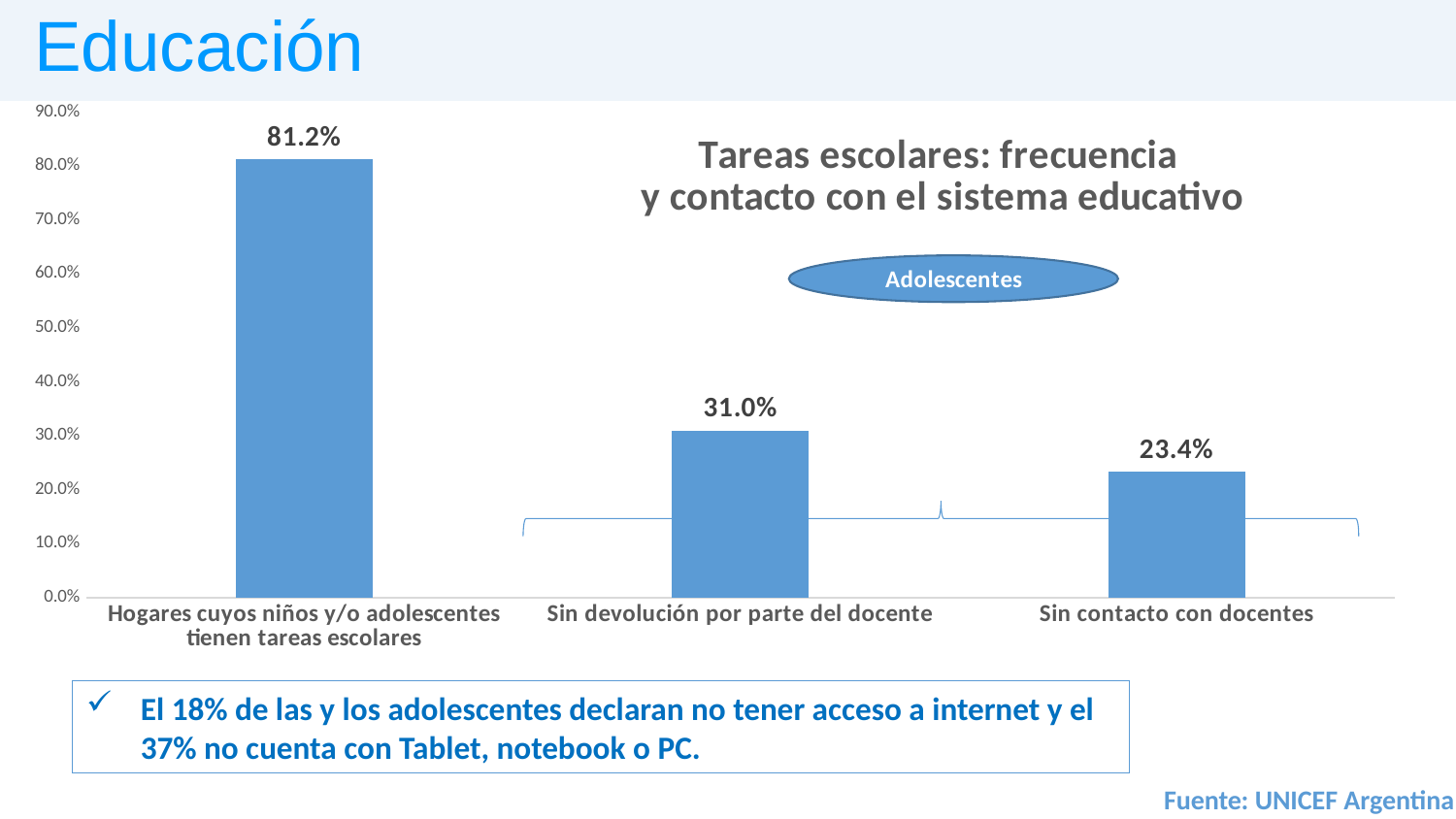
What kind of chart is shown on the slide? Bar chart Which category has the lowest value? Sin contacto con docentes Which is larger: the value for 'Sin devolución por parte del docente' or 'Sin contacto con docentes'? Sin devolución por parte del docente Is the value for 'Sin contacto con docentes' greater or less than 30.0%? less What is the value for 'Sin contacto con docentes'? 23.4% What is the difference between the values for 'Sin devolución por parte del docente' and 'Sin contacto con docentes'? 7.6% What is the title of the chart? Tareas escolares: frecuencia y contacto con el sistema educativo What is the value for 'Sin devolución por parte del docente'? 31.0% How many categories are shown in the chart? 3 What is the difference between the values for 'Hogares cuyos niños y/o adolescentes tienen tareas escolares' and 'Sin devolución por parte del docente'? 50.2% What is the value for 'Hogares cuyos niños y/o adolescentes tienen tareas escolares'? 81.2% Which category has the highest value? Hogares cuyos niños y/o adolescentes tienen tareas escolares